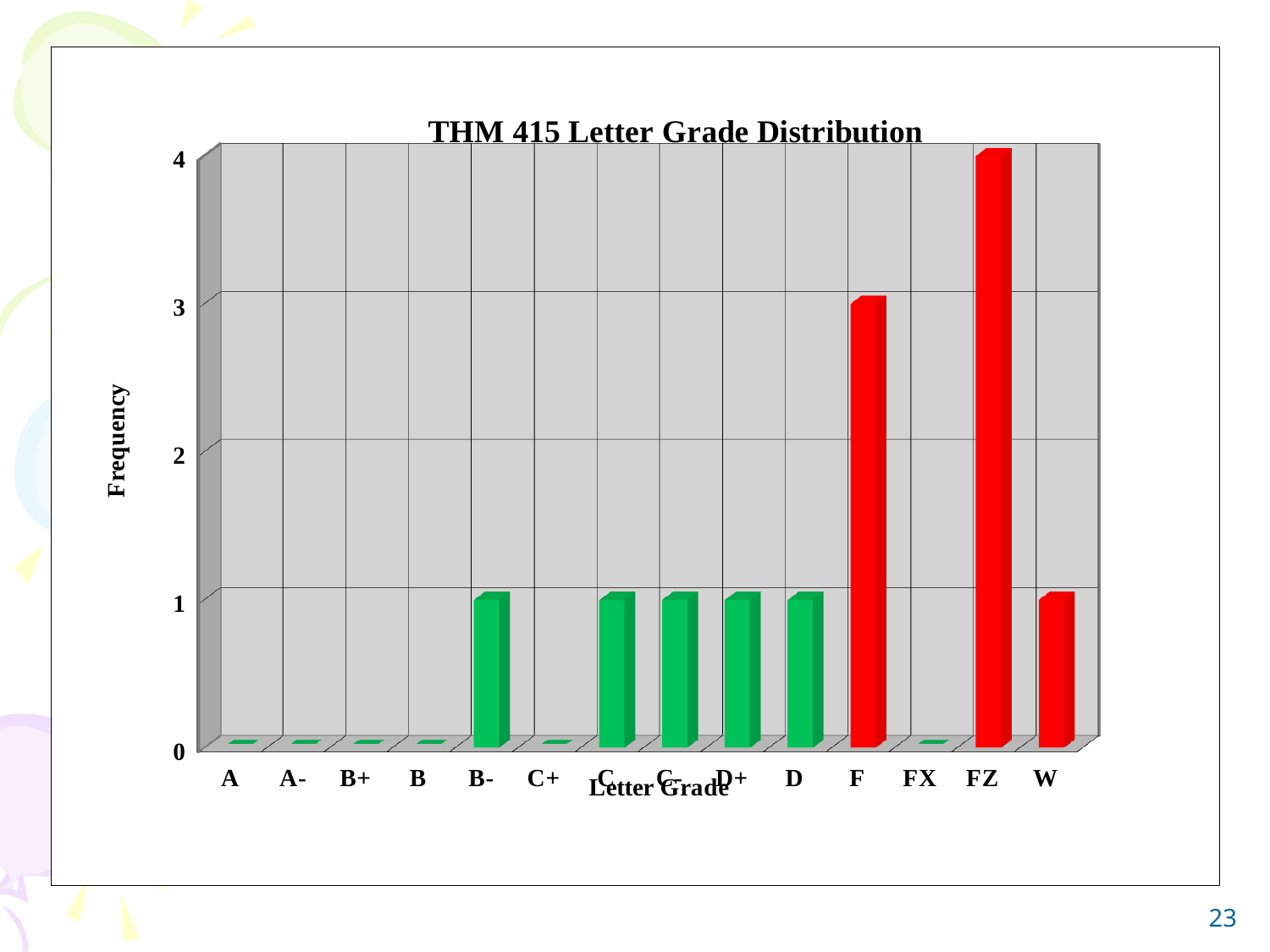
What is the label of the y axis? Frequency Which letter grade has the highest frequency? FZ What is the difference in frequency between FZ and F? 1 What is the frequency for the A grade? 0 Which has a higher frequency, F or W? F What type of chart is shown on the slide? bar chart What is the frequency for the FZ grade? 4 Is the frequency for F greater or less than 2? greater What is the title of the chart? THM 415 Letter Grade Distribution What is the frequency for the B- grade? 1 What is the frequency for the F grade? 3 How many letter grade categories are shown on the x axis? 14